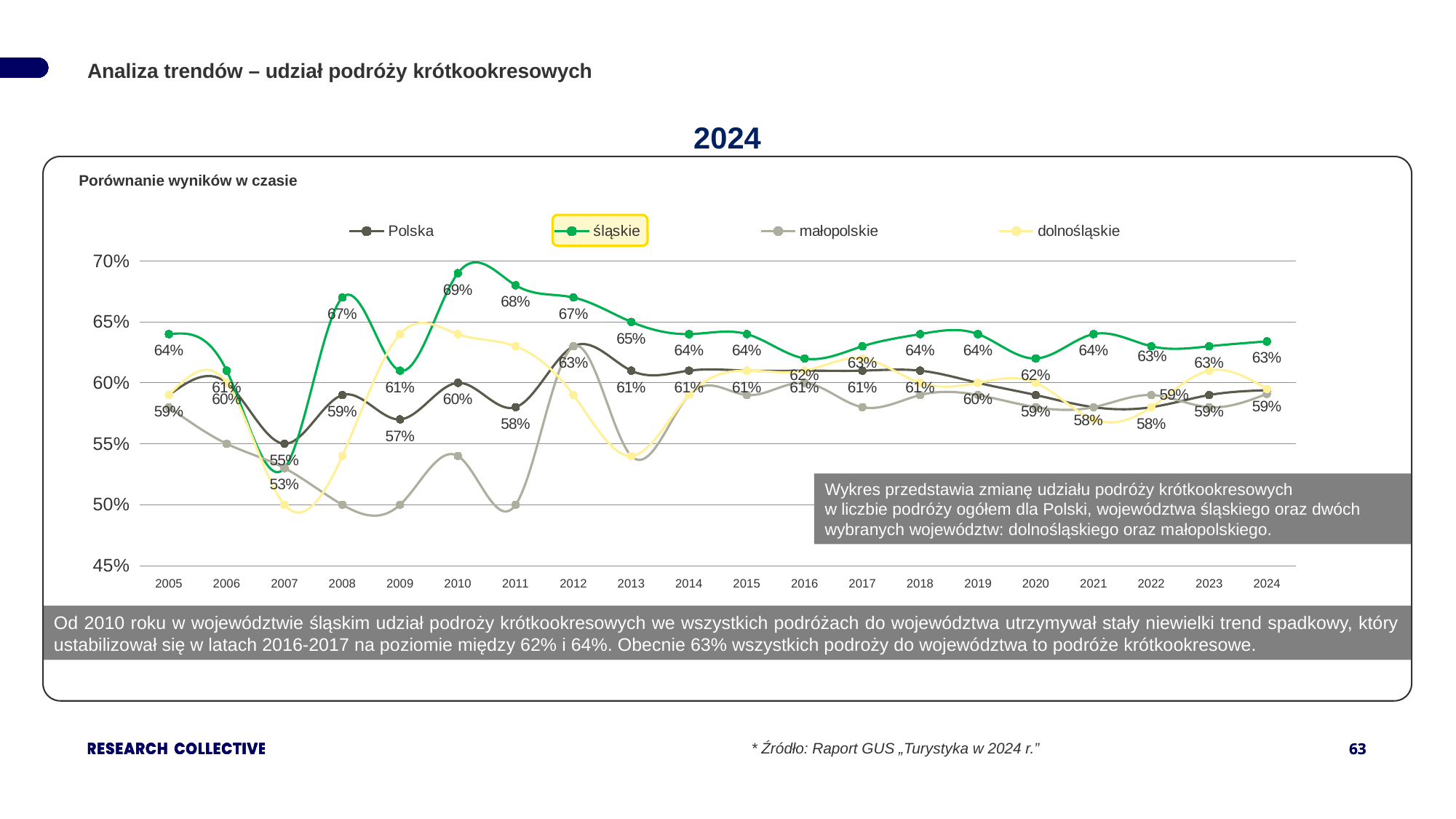
In 2008, which is larger: the value for śląskie or for Polska? śląskie In which year does the śląskie series reach its lowest value? 2007 Does the śląskie series rise or fall from 2010 to 2013? fall What is the value for śląskie in 2010? 69% How many series does the legend list? 4 What is the value for Polska in 2012? 63% Is the value for małopolskie in 2008 greater or less than 55%? less In which year does the śląskie series reach its highest value? 2010 What is the difference between the śląskie and Polska values in 2024? 4 percentage points What is the value for Polska in 2009? 57% How many years are shown on the x axis? 20 What type of chart is shown on the slide? line chart